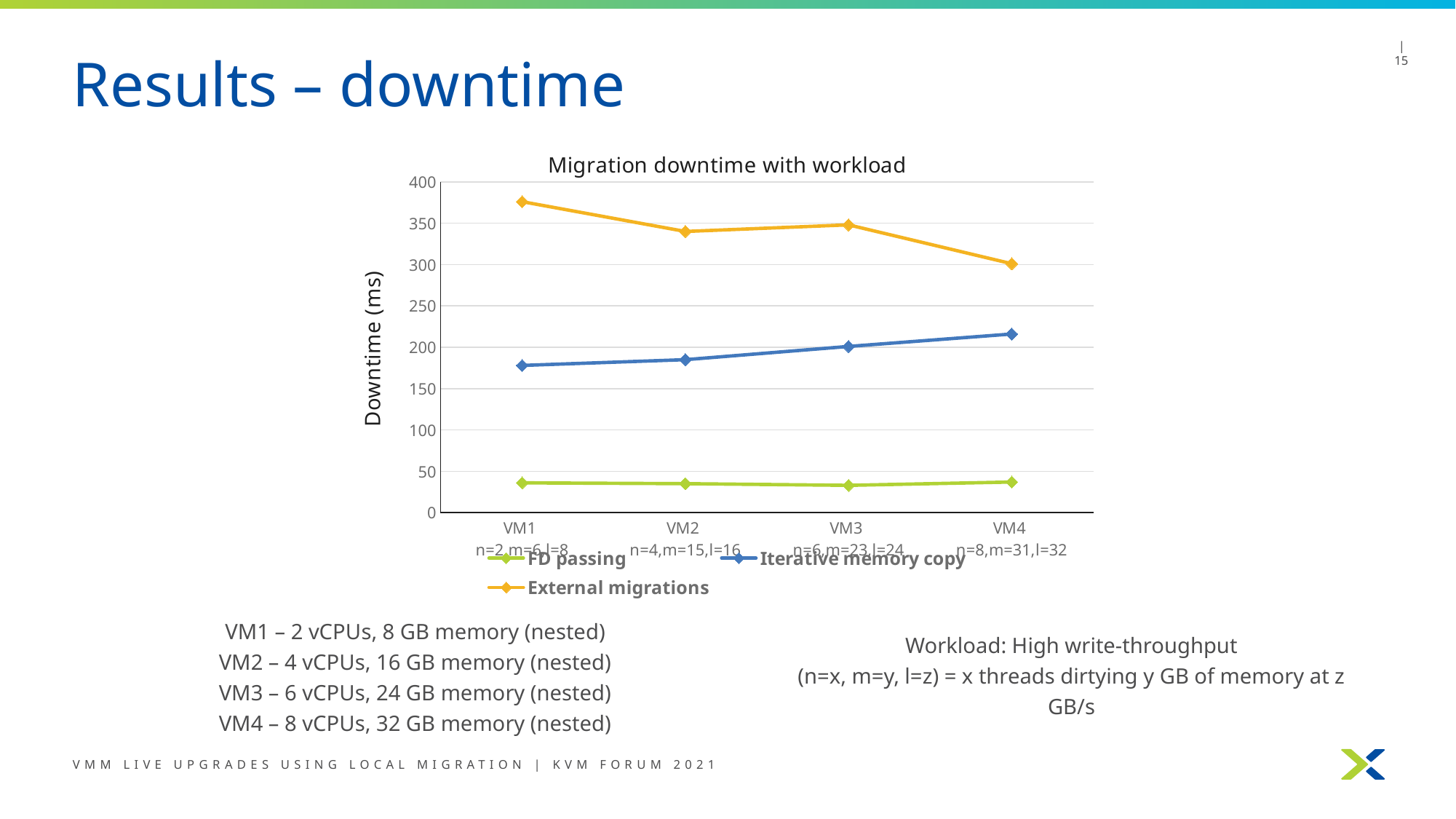
Which series has the larger value at VM1, External migrations or Iterative memory copy? External migrations For which VM is the External migrations downtime lowest? VM4 Is the Iterative memory copy value for VM1 greater or less than 200? less Is the FD passing value for VM1 greater or less than 50? less How many series does the legend list? 3 How many VM categories are plotted along the x axis? 4 What is the label of the vertical axis? Downtime (ms) For which VM is the External migrations downtime highest? VM1 Is the External migrations value for VM1 greater or less than 350? greater What is the title of the chart? Migration downtime with workload What kind of chart is shown on the slide? line chart